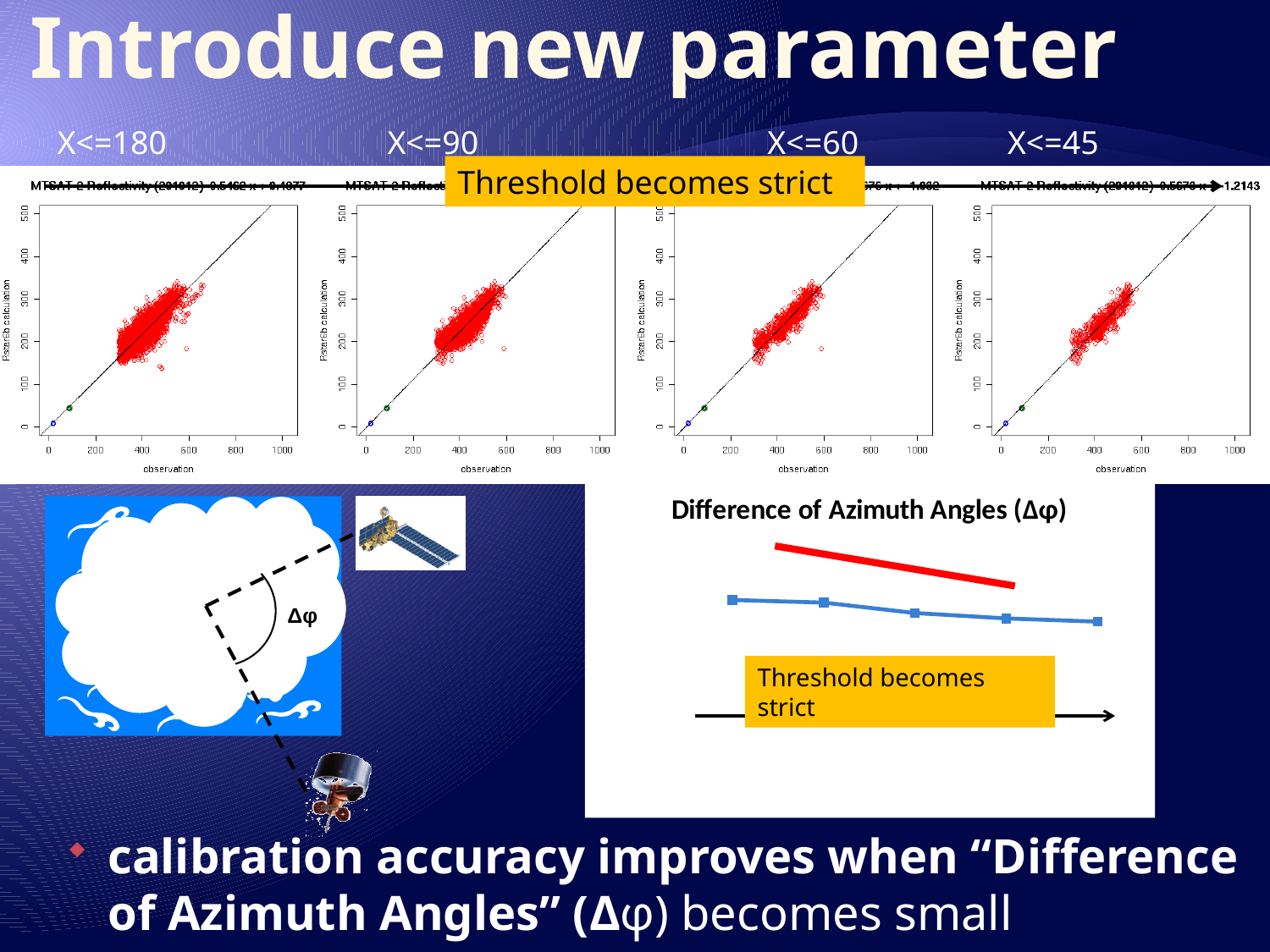
What kind of chart is the chart titled "Difference of Azimuth Angles (Δφ)"? line chart In the chart titled "Difference of Azimuth Angles (Δφ)", how many marked data points are on the blue line? 5 What is the highest x-axis tick value shown on the scatter plot labelled X<=90? 1000 What kind of chart is the chart labelled X<=180 in the top row? scatter plot What threshold label appears above the rightmost scatter plot in the top row? X<=45 In the chart titled "Difference of Azimuth Angles (Δφ)", which line is drawn higher on the chart, the red line or the blue line? red line In the chart titled "Difference of Azimuth Angles (Δφ)", does the blue line rise or fall from left to right? fall What is the x-axis label of the scatter plot labelled X<=45? observation How many scatter plots are shown in the top row of the slide? 4